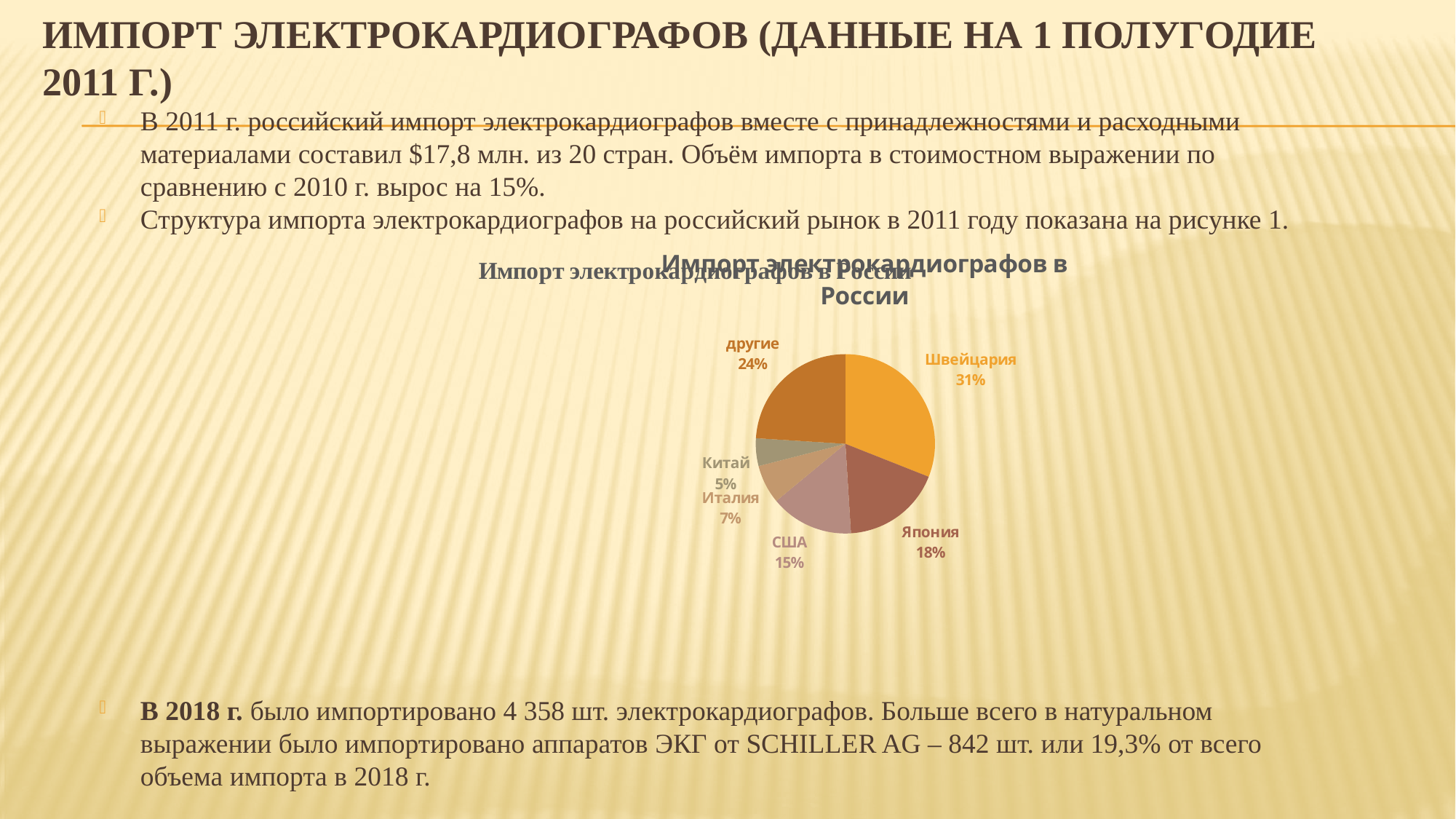
Which is larger, the share for США or the share for Италия? США What kind of chart is shown on the slide? pie chart What share of the pie does Китай have? 5% How many slices does the pie chart have? 6 Which category has the largest slice of the pie? Швейцария What share of the pie does США have? 15% What is the difference in percentage points between Швейцария and Япония? 13 What share of the pie does Япония have? 18% What share of the pie does Швейцария have? 31% Which category has the smallest slice of the pie? Китай What is the difference in percentage points between другие and Китай? 19 What is the title of the chart? Импорт электрокардиографов в России